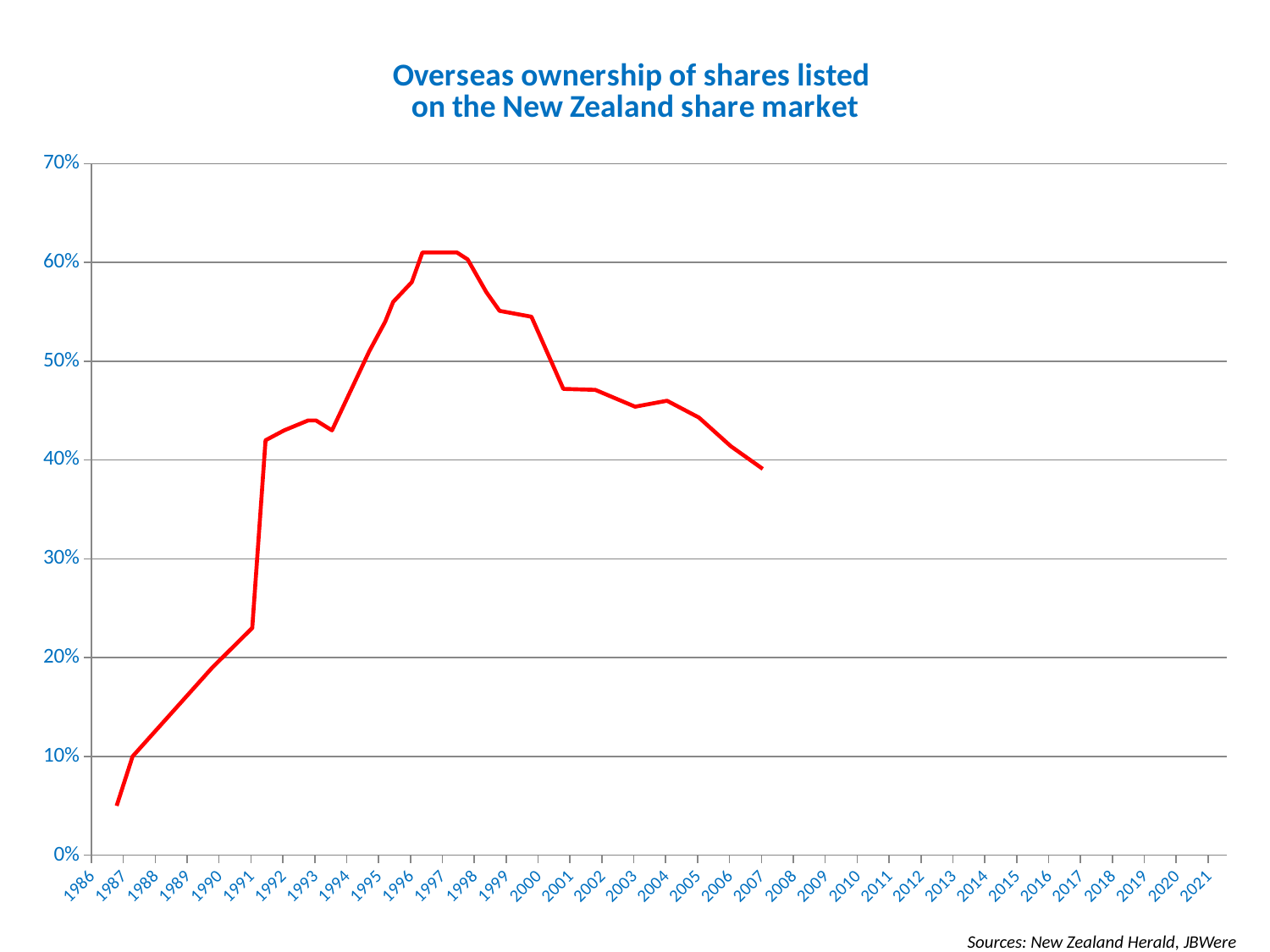
What kind of chart is shown on the slide? line chart What sources are cited below the chart? New Zealand Herald, JBWere Is the value for 2007 greater or less than 40%? less Is the value for 2001 greater or less than 50%? less Does the line rise or fall between 1997 and 2007? fall Is the value for 1995 greater or less than 50%? greater In which year is the plotted value lowest? 1987 What is the title of the chart? Overseas ownership of shares listed on the New Zealand share market Which year has the larger value, 1995 or 2005? 1995